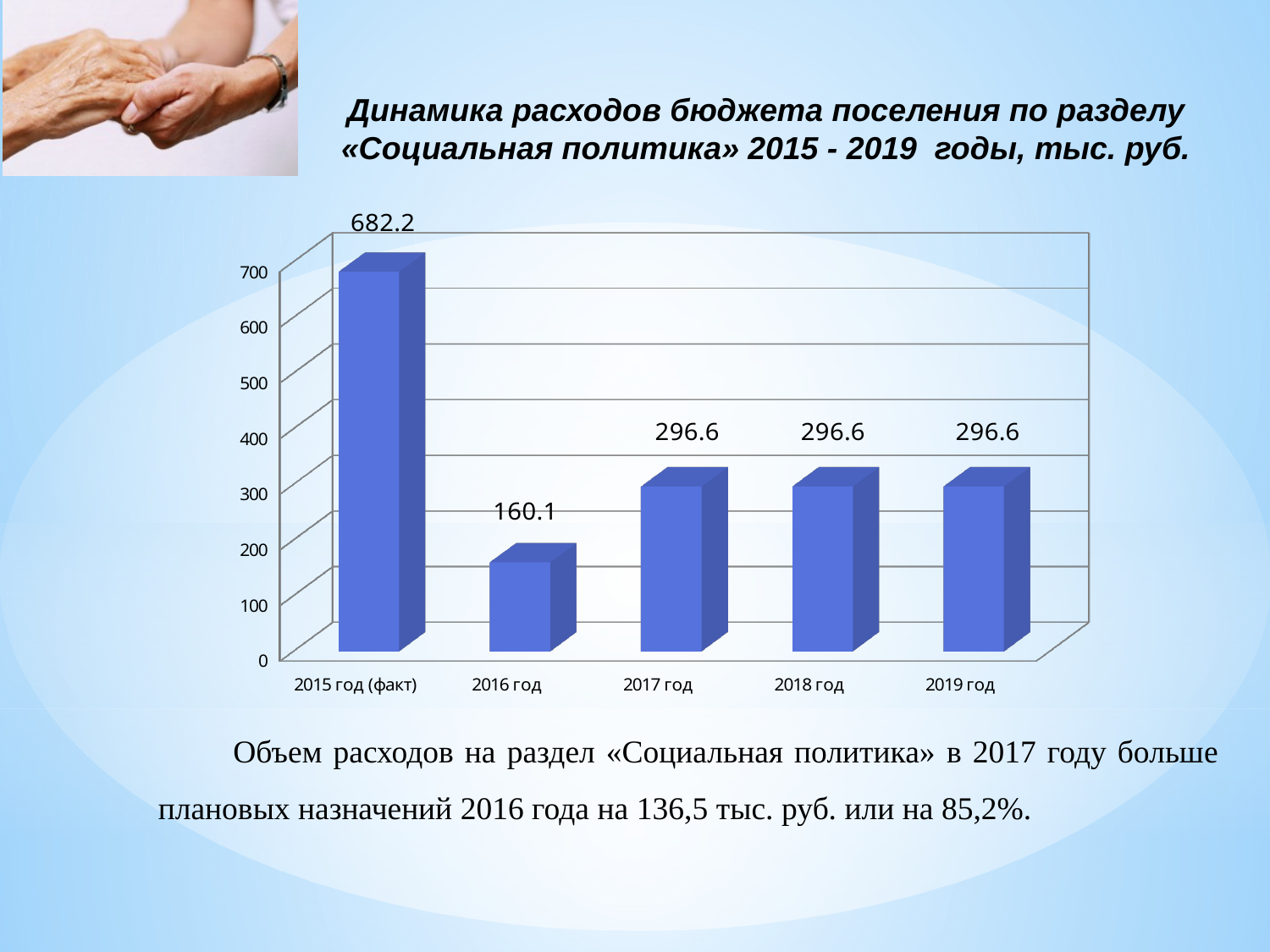
Which category has the highest value? 2015 год (факт) What is the value for 2016 год? 160.1 What kind of chart is shown on the slide? bar chart What is the value for 2018 год? 296.6 Is the value for 2017 год greater or less than 200? greater What is the value for 2015 год (факт)? 682.2 Do the values rise or fall from 2015 год (факт) to 2016 год? fall How many categories are shown on the x axis? 5 What is the difference between the values for 2017 год and 2016 год? 136.5 What is the difference between the values for 2015 год (факт) and 2016 год? 522.1 Which category has the lowest value? 2016 год Which is larger, the value for 2016 год or the value for 2019 год? 2019 год